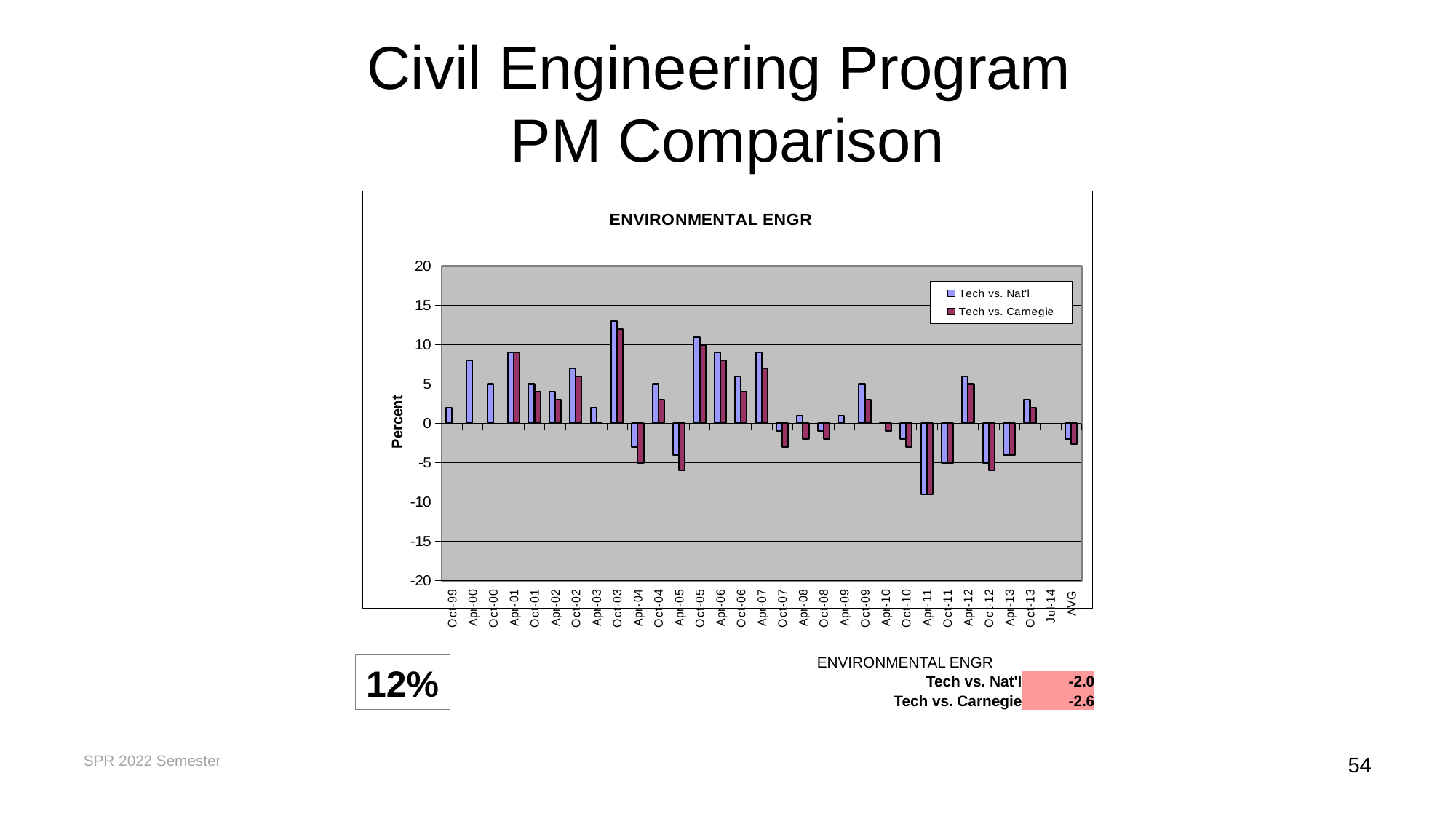
Is the Tech vs. Nat'l value for Oct-03 greater or less than 10? greater What is the label on the vertical axis of the chart? Percent How many series does the chart legend list? 2 How many categories are shown along the x axis of the chart? 31 Is the Tech vs. Nat'l value for Apr-11 greater or less than -5? less In which period does the Tech vs. Nat'l series reach its highest value? Oct-03 Is the Tech vs. Carnegie value for Oct-07 greater or less than 0? less According to the table below the chart, what is the Tech vs. Carnegie value for ENVIRONMENTAL ENGR? -2.6 In which period does the Tech vs. Nat'l series reach its lowest value? Apr-11 What type of chart is shown on the slide? bar chart Which is larger for the Tech vs. Nat'l series: the value for Oct-03 or the value for Apr-06? Oct-03 What is the title of the chart? ENVIRONMENTAL ENGR